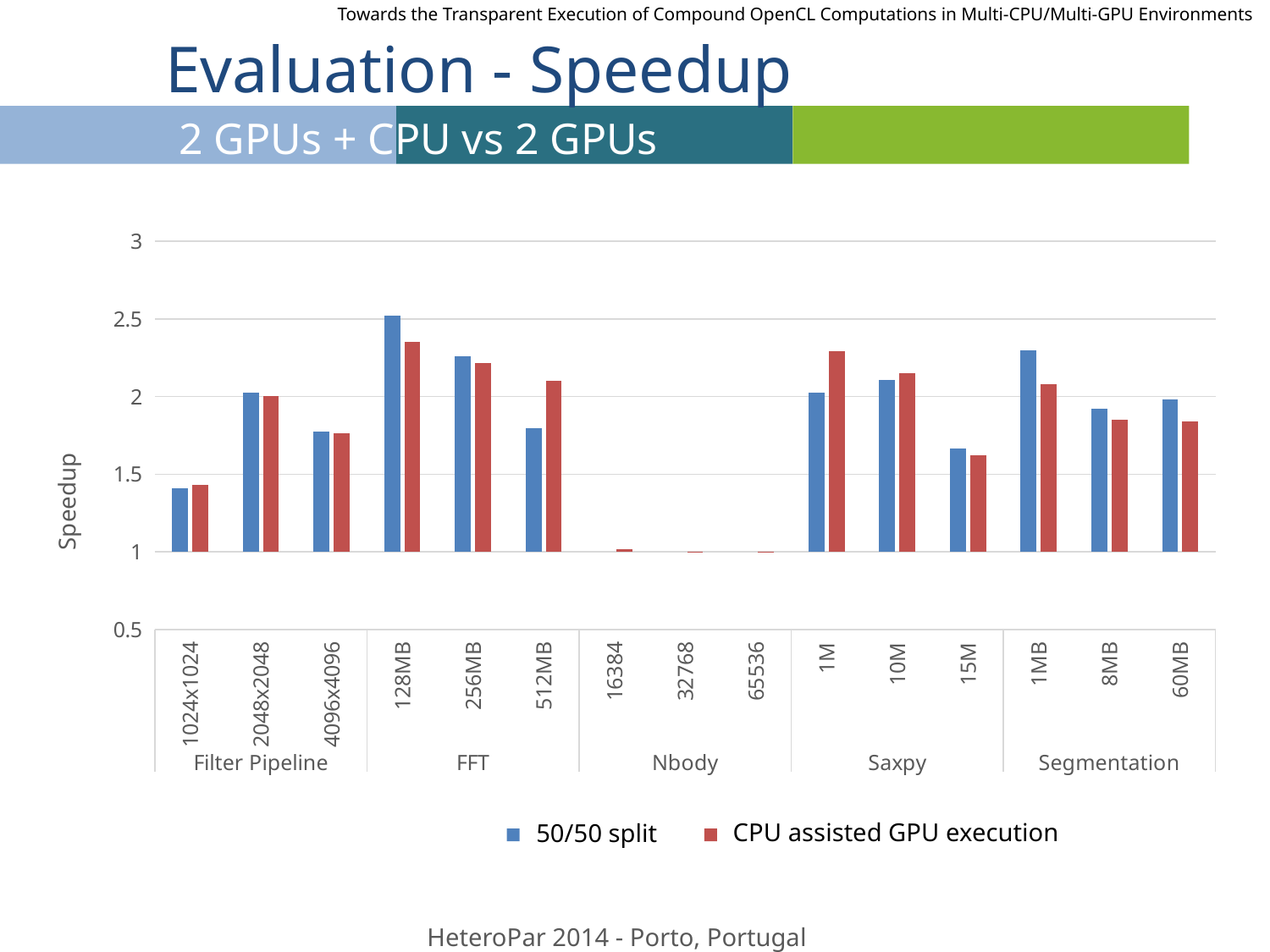
How many benchmark groups are shown along the x axis? 5 What is the label of the y axis? Speedup How many series does the legend list? 2 Within the FFT group, does the 50/50 split speedup rise or fall as the input size increases from 128MB to 512MB? fall What kind of chart is shown on the slide? bar chart Is the CPU assisted GPU execution speedup for Saxpy at 15M greater or less than 2? less Is the 50/50 split speedup for FFT at 128MB greater or less than 2? greater For Segmentation at 1MB, which series has the larger speedup, 50/50 split or CPU assisted GPU execution? 50/50 split Which series is shown in red in the legend? CPU assisted GPU execution Within the Filter Pipeline group, which input size has the lowest 50/50 split speedup? 1024x1024 For FFT at 512MB, which series has the larger speedup, 50/50 split or CPU assisted GPU execution? CPU assisted GPU execution For which input size does the 50/50 split series reach its highest speedup? 128MB (FFT)